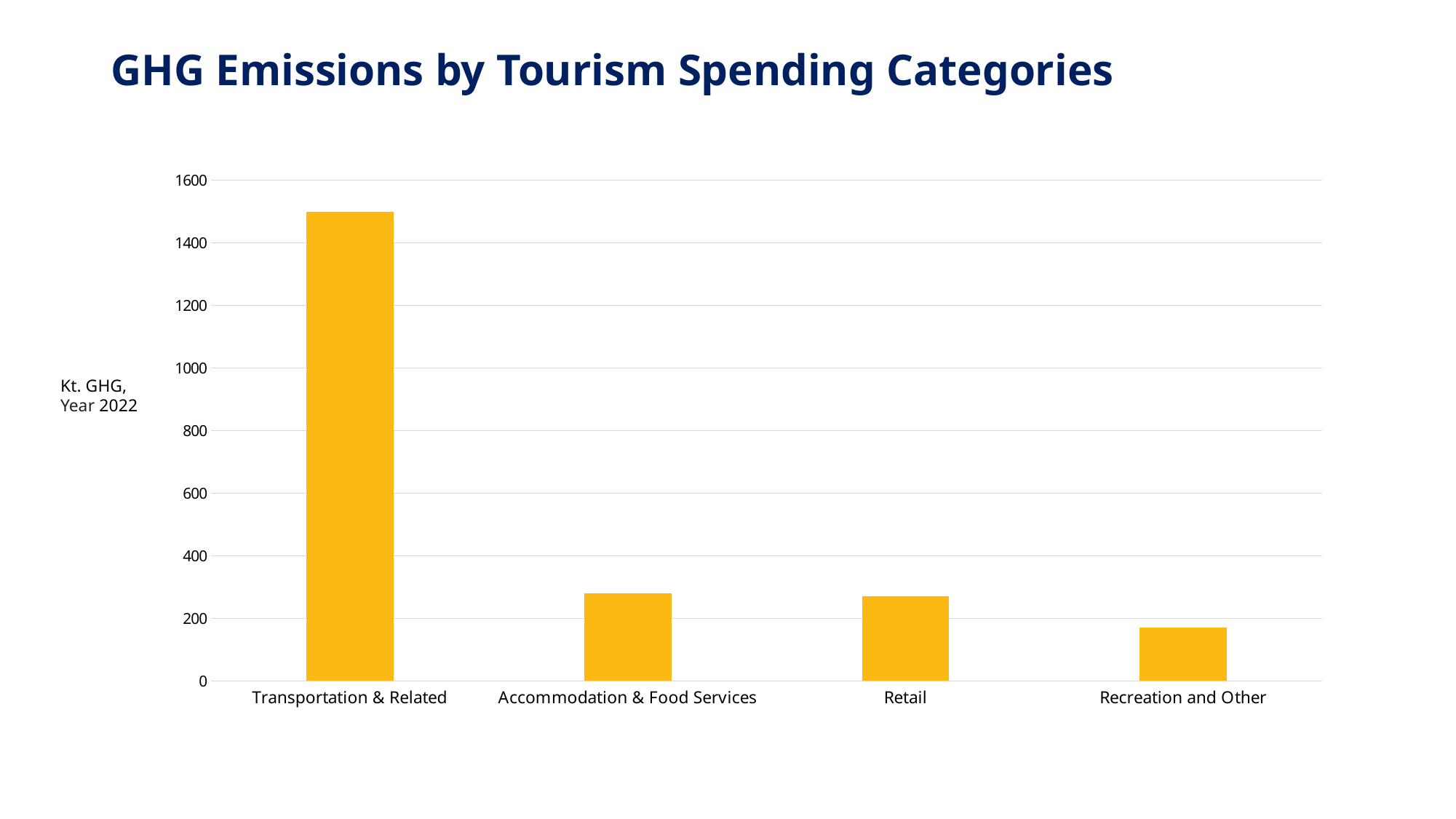
Is the value for Recreation and Other greater or less than 200? less Is the value for Transportation & Related greater or less than 1600? less What type of chart is shown on the slide? bar chart Is the value for Retail greater or less than 400? less How many categories are shown on the x axis? 4 Which category has the lowest GHG emissions? Recreation and Other What is the title of the chart? GHG Emissions by Tourism Spending Categories Which is larger, the value for Transportation & Related or the value for Retail? Transportation & Related Which category has the highest GHG emissions? Transportation & Related Which is larger, the value for Accommodation & Food Services or the value for Recreation and Other? Accommodation & Food Services